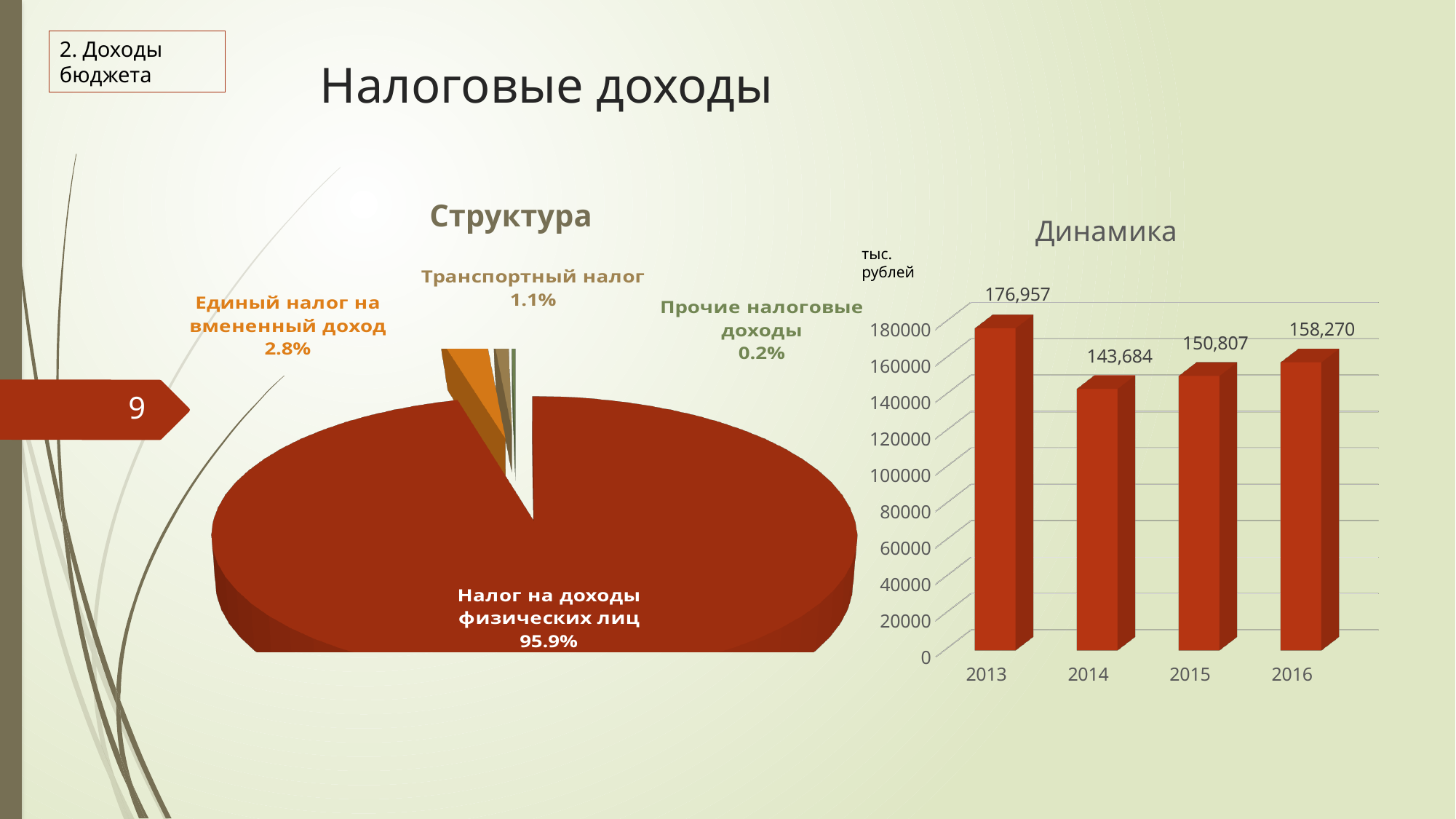
In the 'Динамика' chart, what is the difference between the values for 2013 and 2014? 33,273 In the 'Динамика' chart, what is the value for 2013? 176,957 In the 'Структура' pie chart, what share does 'Единый налог на вмененный доход' have? 2.8% What kind of chart is the 'Динамика' chart? Bar chart What kind of chart is the 'Структура' chart? Pie chart In the 'Структура' pie chart, what share does 'Налог на доходы физических лиц' have? 95.9% In the 'Структура' pie chart, which category has the smallest share? Прочие налоговые доходы How many slices does the 'Структура' pie chart have? 4 In the 'Динамика' chart, what is the value for 2016? 158,270 In the 'Динамика' chart, which year has the lowest value? 2014 In the 'Структура' pie chart, what share does 'Транспортный налог' have? 1.1% In the 'Динамика' chart, which is larger: the value for 2015 or the value for 2016? 2016